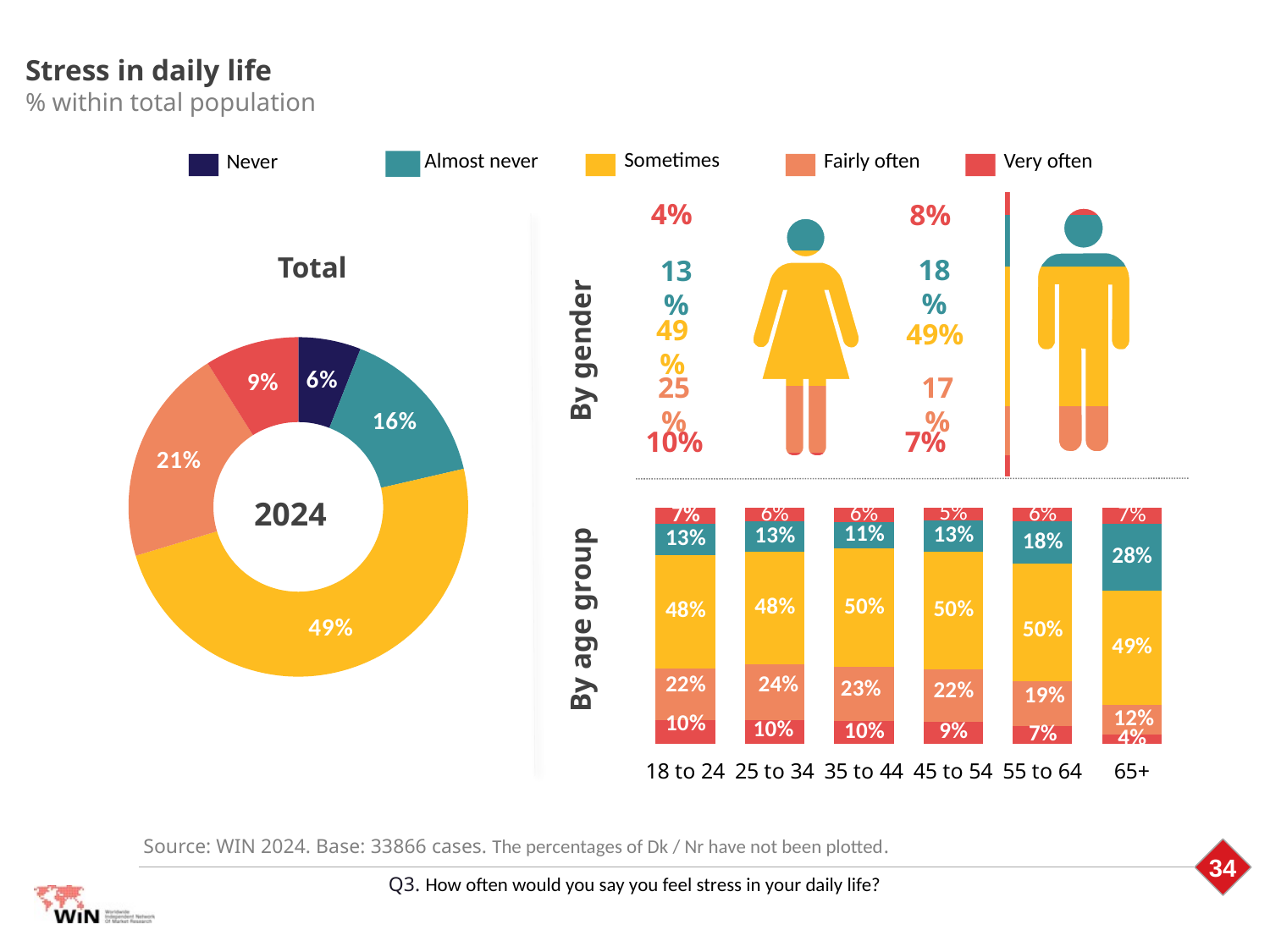
In the By gender section, which gender has the higher Fairly often percentage? Women In the Total donut chart, which category has the largest share? Sometimes How many categories does the legend list? 5 What kind of chart is the Total chart on the left? Pie (donut) chart How many age groups are shown in the By age group chart? 6 In the By age group chart, what is the Almost never percentage for the 65+ group? 28% In the Total donut chart, what percentage is shown for Never? 6% In the By gender section, what is the Almost never percentage for men? 18% In the By age group chart, which age group has the highest Almost never percentage? 65+ In the Total donut chart, what is the difference between the Fairly often and Very often shares? 12% In the Total donut chart, what percentage is shown for Sometimes? 49% In the Total donut chart, which category has the smallest share? Never